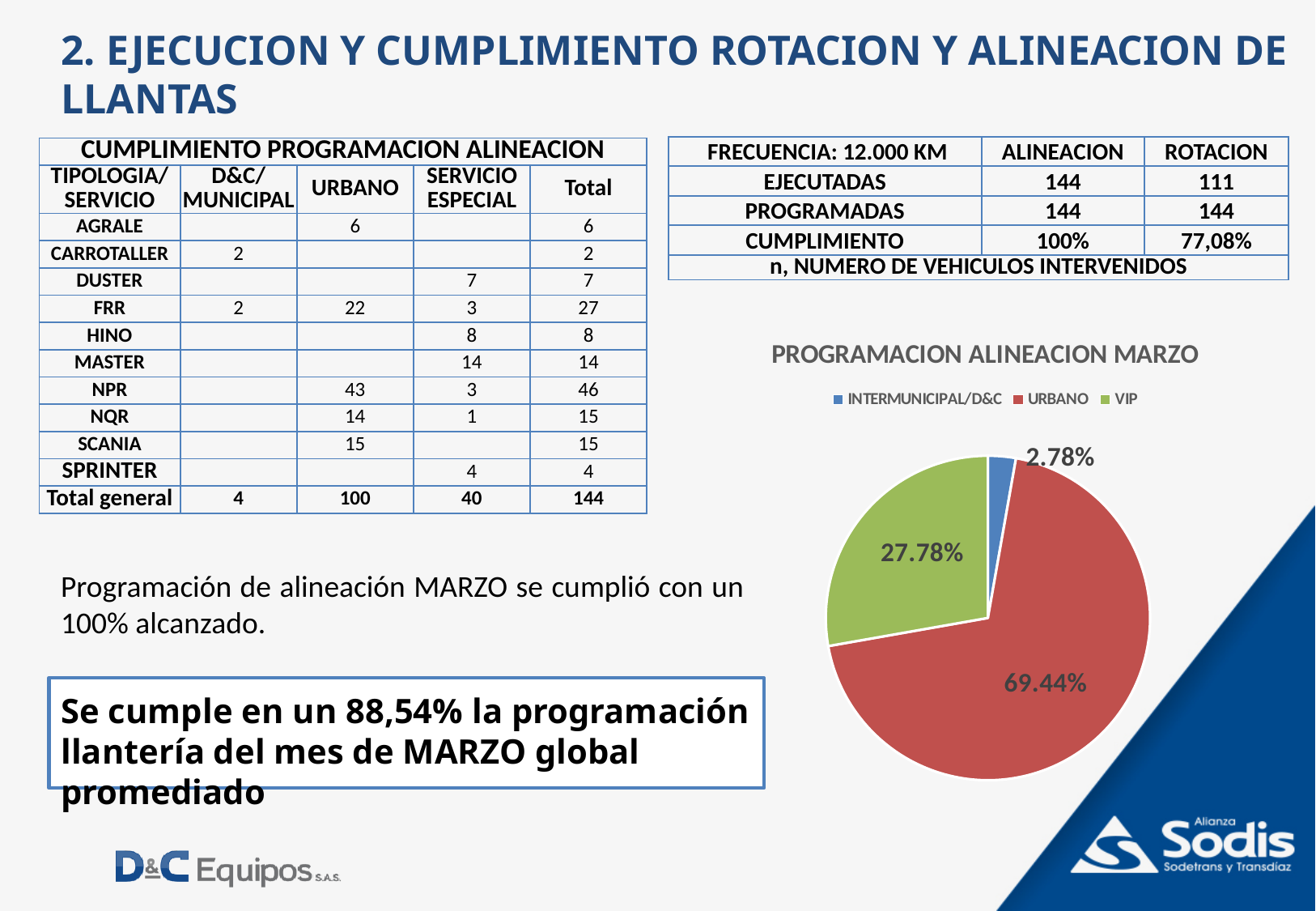
What is the difference in percentage points between the URBANO and VIP slices? 41.66 What type of chart is shown on the slide? pie chart What share of the pie chart does VIP represent? 27.78% How many entries does the legend of the pie chart list? 3 Which category has the smallest slice in the pie chart? INTERMUNICIPAL/D&C How many slices does the pie chart have? 3 Which slice is larger in the pie chart, VIP or INTERMUNICIPAL/D&C? VIP What colour is the URBANO slice in the pie chart? red Which category has the largest slice in the pie chart? URBANO What is the title of the chart on the slide? PROGRAMACION ALINEACION MARZO What share of the pie chart does INTERMUNICIPAL/D&C represent? 2.78% What share of the pie chart does URBANO represent? 69.44%